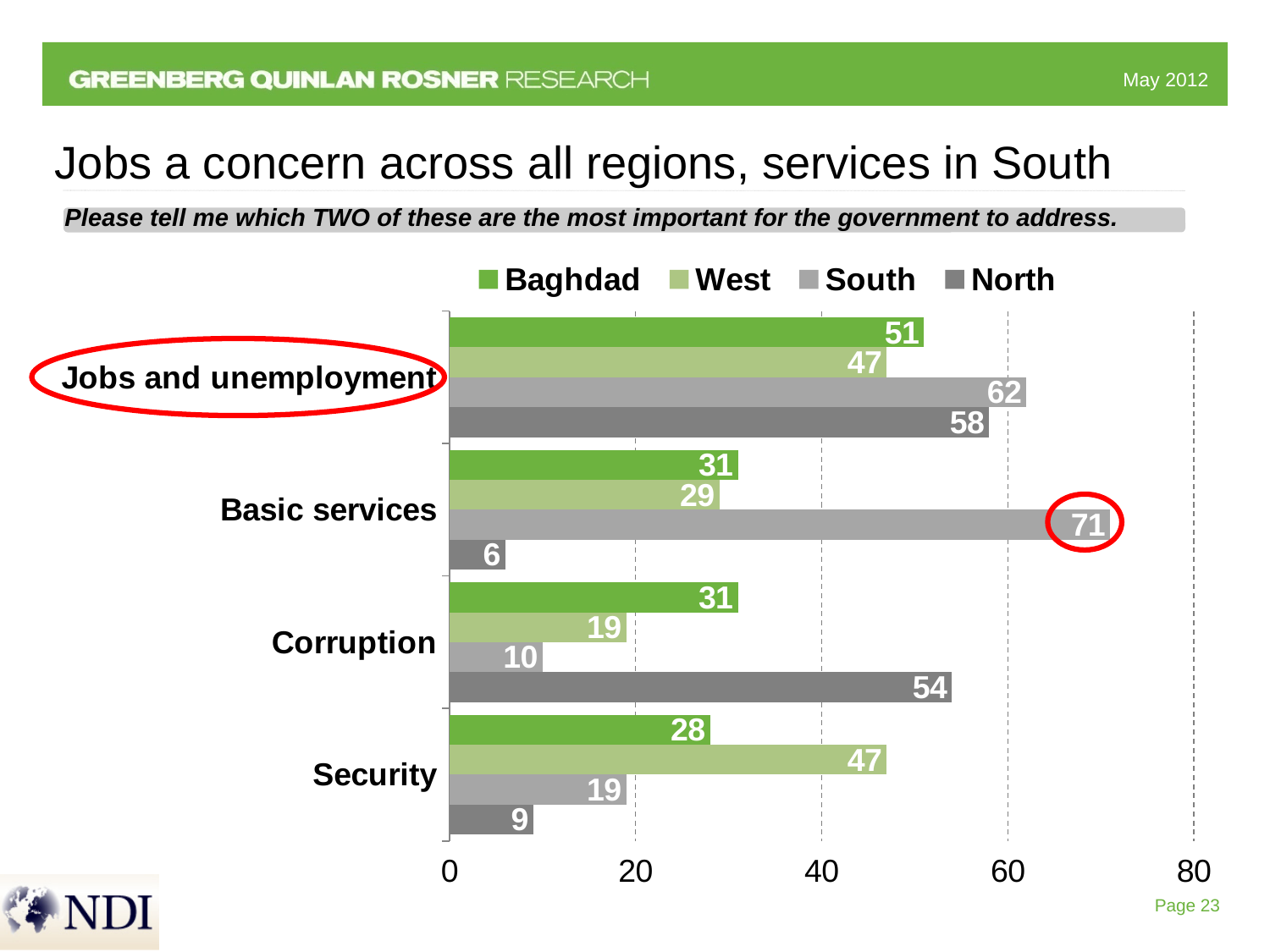
What is the value for West for Security? 47 What is the value for North for Corruption? 54 How many categories are shown on the chart? 4 Which is larger for Corruption: the Baghdad value or the West value? Baghdad What kind of chart is shown on the slide? Bar chart Which region has the highest value for Jobs and unemployment? South How many series does the legend list? 4 Which category is circled in red on the left of the chart? Jobs and unemployment Is the value for North for Jobs and unemployment greater or less than 40? greater What is the value for South for Basic services? 71 What is the difference between the South and North values for Basic services? 65 Which region has the lowest value for Basic services? North